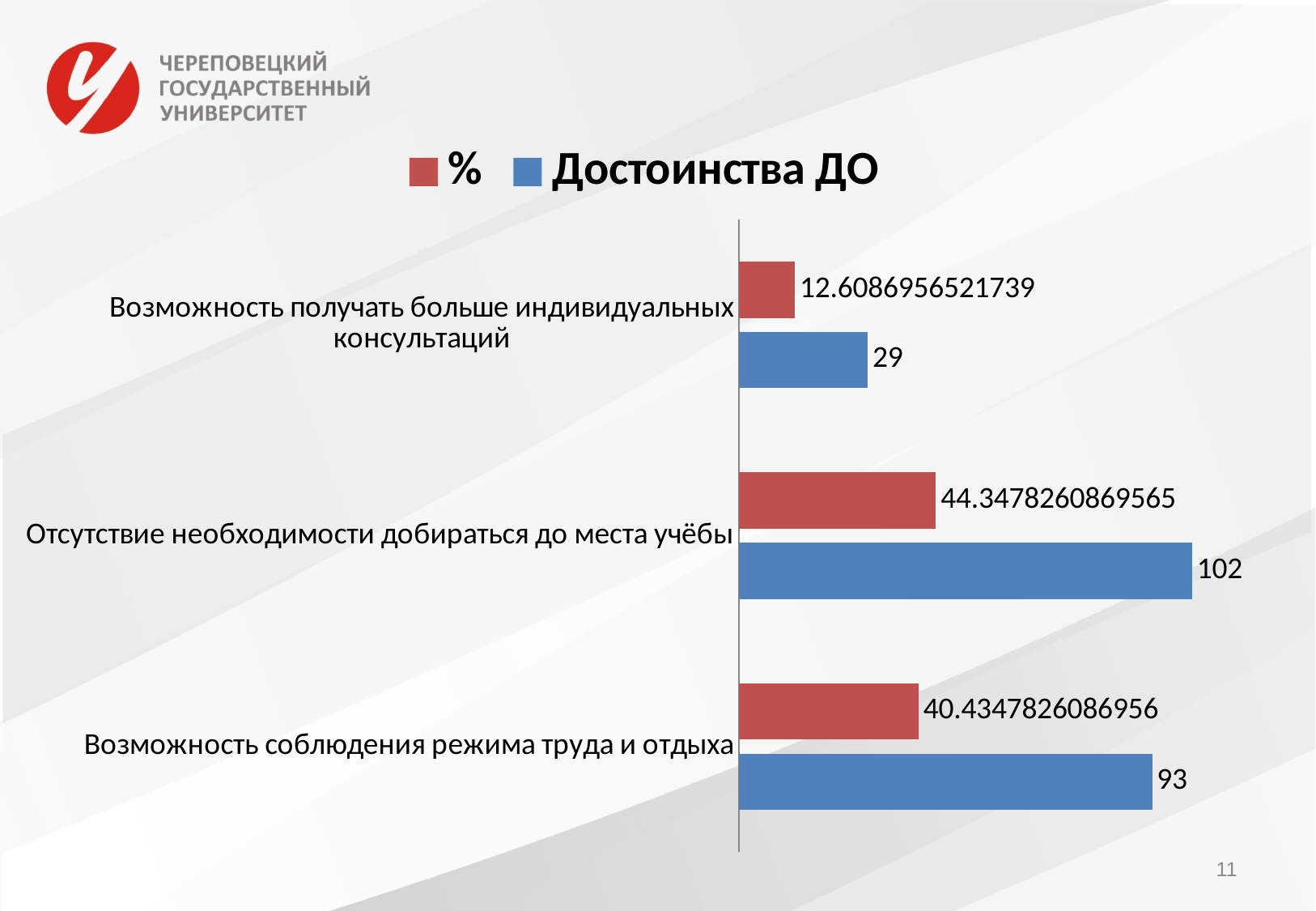
How many categories are shown in the chart? 3 What is the value of the 'Достоинства ДО' series for 'Возможность соблюдения режима труда и отдыха'? 93 What is the '%' value for 'Отсутствие необходимости добираться до места учёбы'? 44.3478260869565 Which series is shown in red in the legend? % What is the value of the 'Достоинства ДО' series for 'Отсутствие необходимости добираться до места учёбы'? 102 Which category has the highest value in the 'Достоинства ДО' series? Отсутствие необходимости добираться до места учёбы What type of chart is shown on the slide? bar chart What is the '%' value for 'Возможность получать больше индивидуальных консультаций'? 12.6086956521739 How many series does the legend list? 2 What is the value of the 'Достоинства ДО' series for 'Возможность получать больше индивидуальных консультаций'? 29 Which category has the lowest value in the 'Достоинства ДО' series? Возможность получать больше индивидуальных консультаций What is the difference between the 'Достоинства ДО' values for 'Отсутствие необходимости добираться до места учёбы' and 'Возможность соблюдения режима труда и отдыха'? 9